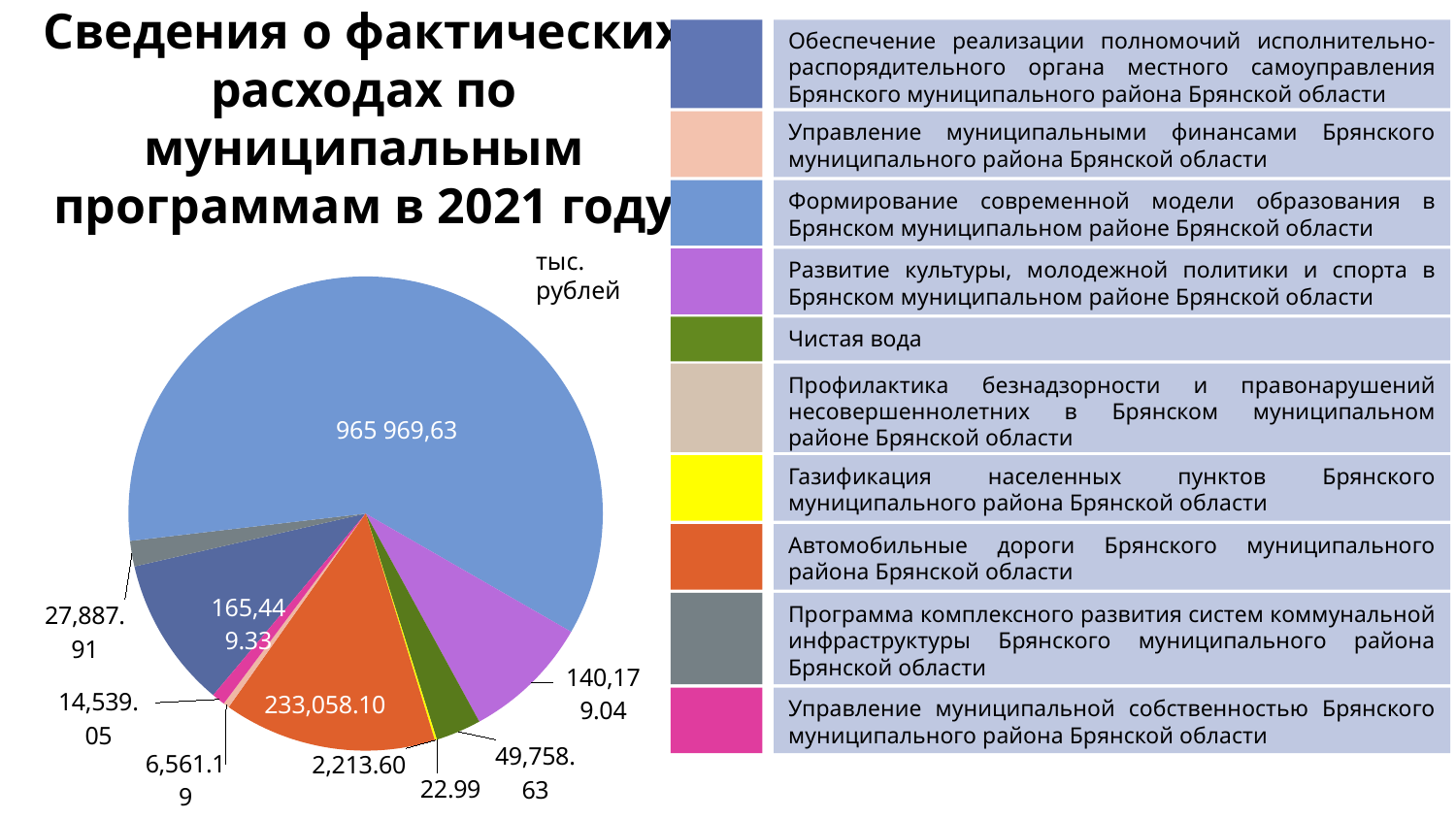
What is the value shown for Автомобильные дороги Брянского муниципального района Брянской области? 233,058.10 What is the value shown for Формирование современной модели образования? 965 969,63 Which category has the smallest slice of the pie? Профилактика безнадзорности и правонарушений несовершеннолетних в Брянском муниципальном районе Брянской области What is the value shown for Чистая вода? 49,758.63 Which category has the largest slice of the pie? Формирование современной модели образования в Брянском муниципальном районе Брянской области What is the value shown for Газификация населенных пунктов Брянского муниципального района Брянской области? 2,213.60 What colour is the slice for Чистая вода? green Which is larger: the value for Автомобильные дороги or the value for Развитие культуры, молодежной политики и спорта? Автомобильные дороги How many slices does the pie chart have? 10 What unit is indicated next to the pie chart? тыс. рублей What kind of chart is shown on the slide? pie chart What is the difference between the value for Автомобильные дороги (233,058.10) and the value for Развитие культуры, молодежной политики и спорта (140,179.04)? 92,879.06